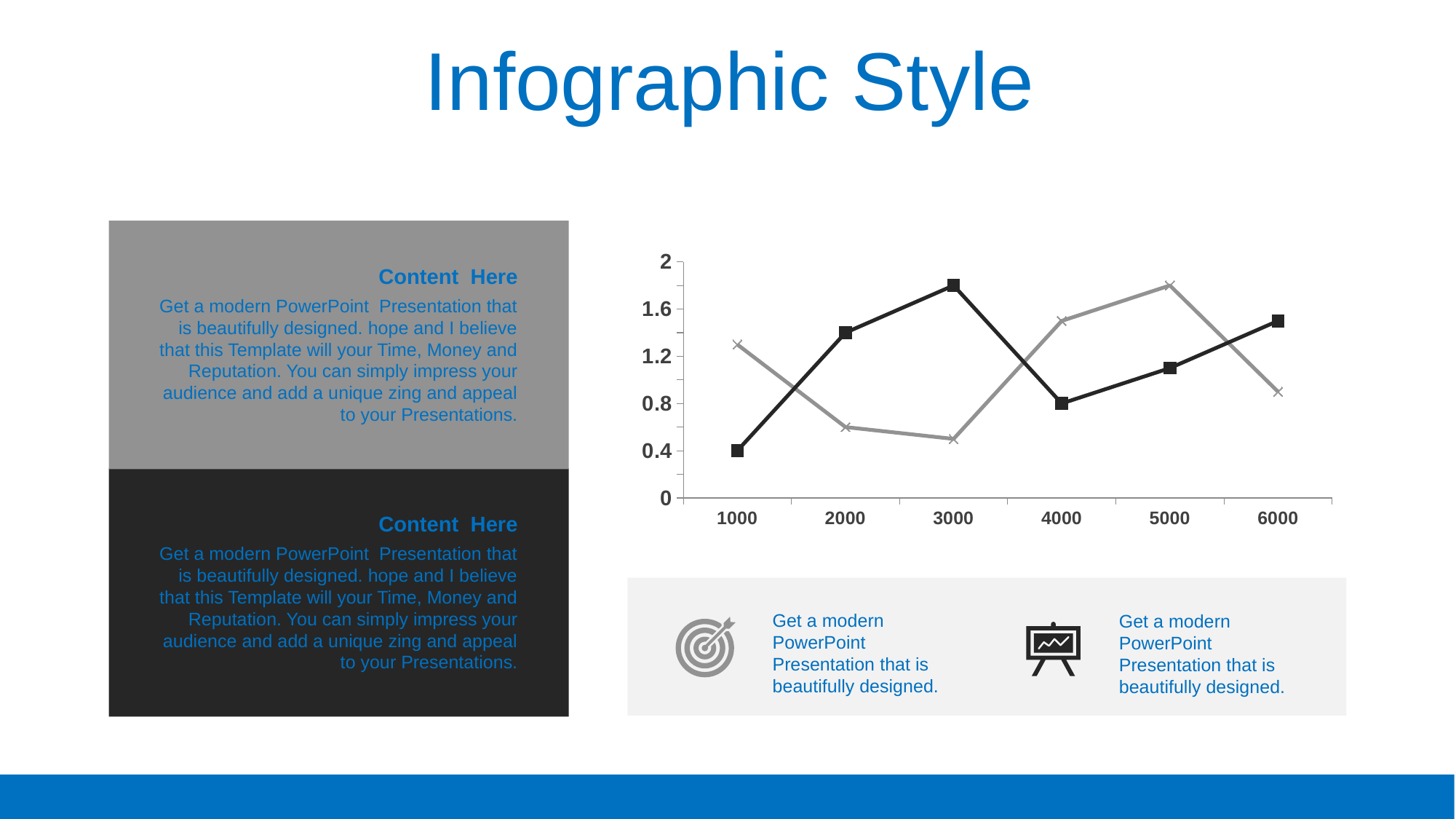
Is the value of the gray line at 3000 greater or less than 0.8? less At which x-axis value does the black line reach its lowest point? 1000 How many lines are plotted on the chart? 2 At which x-axis value does the gray line reach its highest point? 5000 Is the value of the black line at 1000 greater or less than 0.8? less Does the black line rise or fall from 1000 to 3000? rise At 1000, which line has the higher value, the black line or the gray line? gray line What kind of chart is shown on the slide? line chart Is the value of the gray line at 5000 greater or less than 1.6? greater At which x-axis value does the black line reach its highest point? 3000 How many points are plotted along the x axis for each line? 6